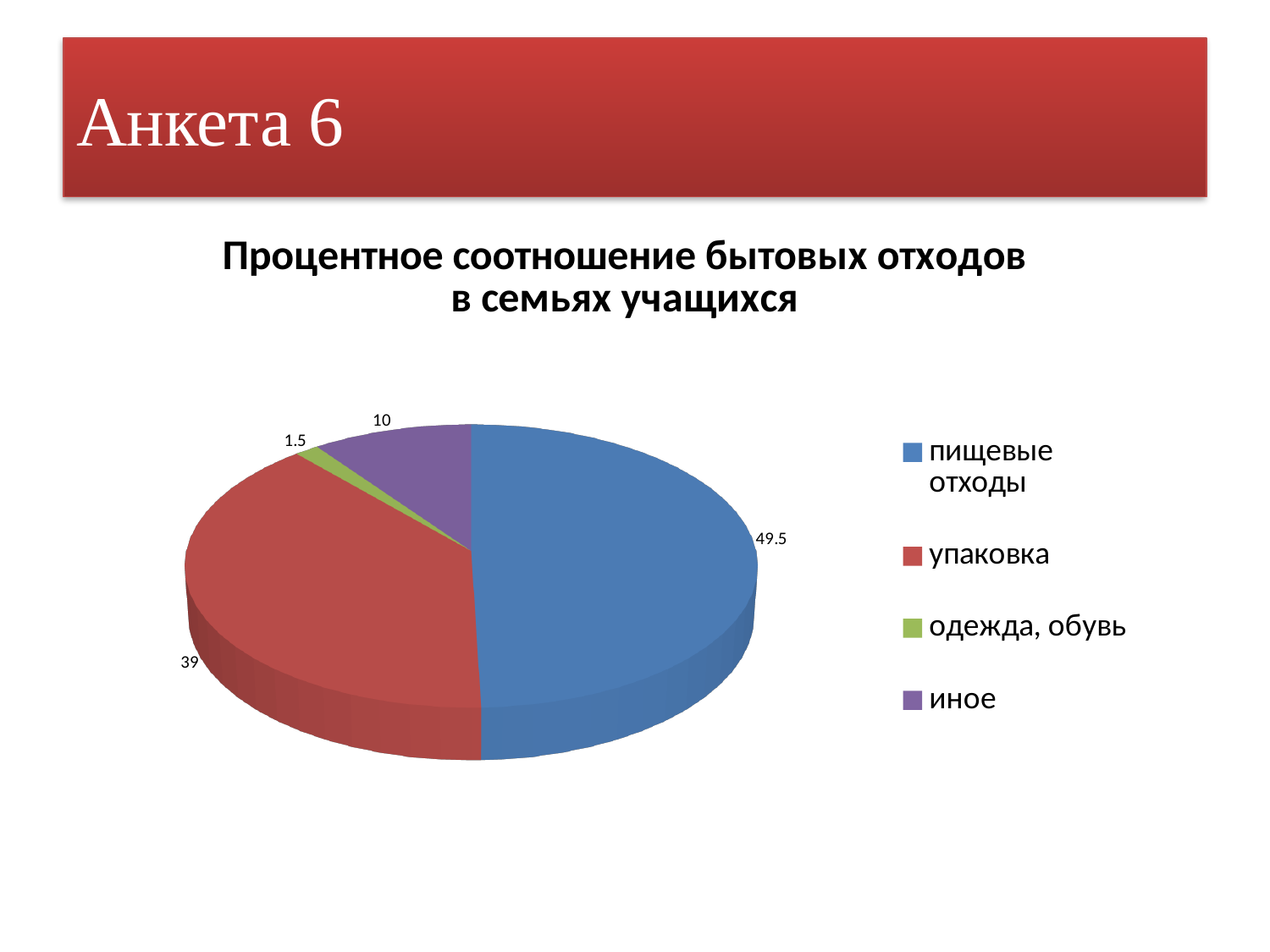
What is the value for иное? 10 What type of chart is shown on the slide? pie chart Which category has the largest slice? пищевые отходы How many categories does the pie chart have? 4 What is the value for упаковка? 39 Which is larger, the value for иное or the value for одежда, обувь? иное What is the value for одежда, обувь? 1.5 Which category has the smallest slice? одежда, обувь What is the difference between the values for пищевые отходы and упаковка? 10.5 What colour is the slice for упаковка? red What is the title of the chart? Процентное соотношение бытовых отходов в семьях учащихся What is the value for пищевые отходы? 49.5